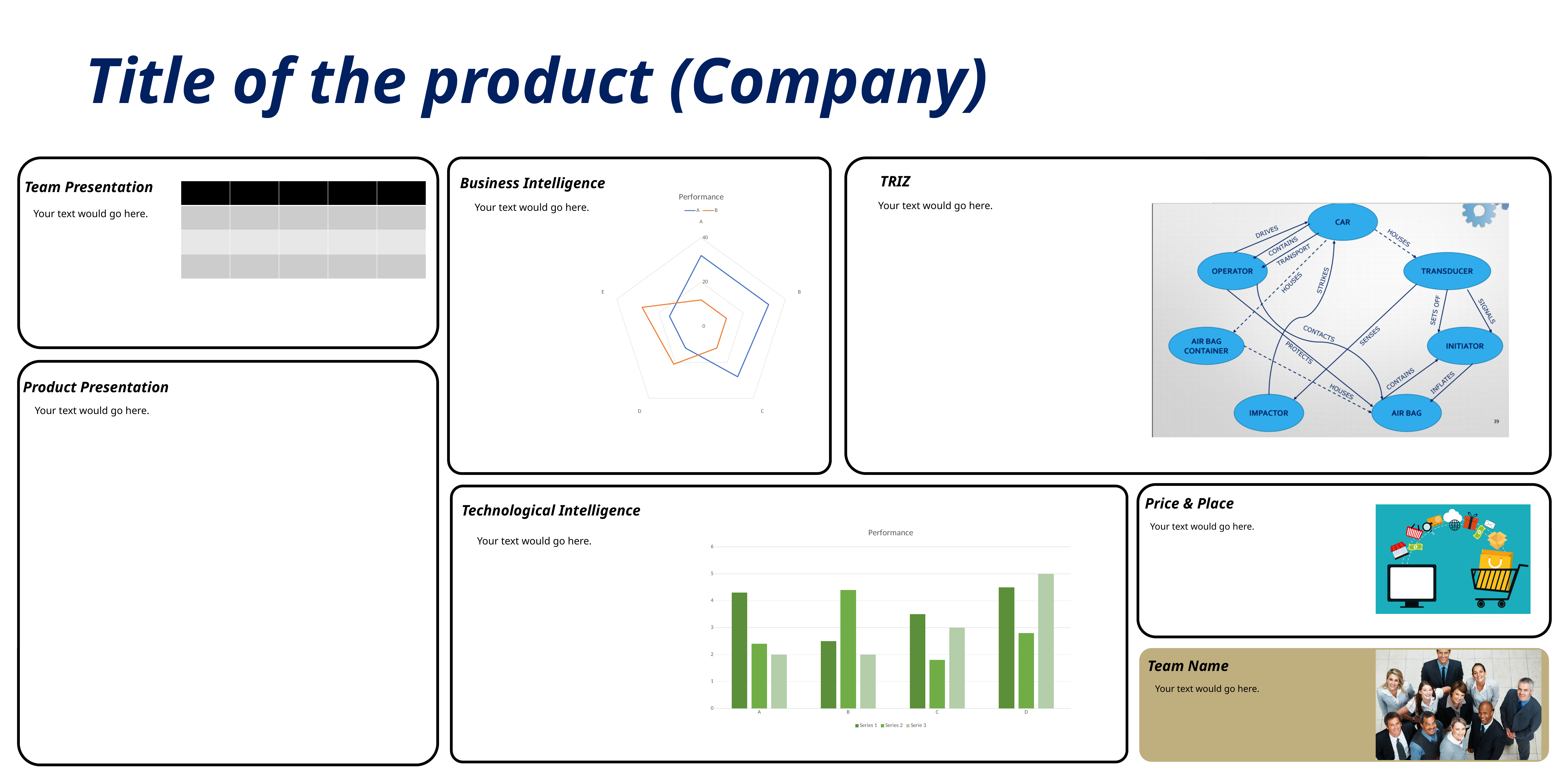
In the Business Intelligence radar chart, how many series does the legend list? 2 What kind of chart is shown in the Business Intelligence section? radar chart In the Technological Intelligence bar chart, what is the value of Serie 3 for category D? 5 In the Technological Intelligence bar chart, how many series does the legend list? 3 In the Technological Intelligence bar chart, how many categories are shown on the x axis? 4 In the Technological Intelligence bar chart, for category B, which is larger: Series 1 or Series 2? Series 2 In the Technological Intelligence bar chart, is the value of Series 1 for category A greater or less than 4? greater In the Business Intelligence radar chart, how many axes (categories) are there? 5 What kind of chart is shown in the Technological Intelligence section? bar chart In the Technological Intelligence bar chart, which category has the highest value for Serie 3? D In the Technological Intelligence bar chart, what is the value of Serie 3 for category C? 3 In the Business Intelligence radar chart, is the value of series A on axis A greater or less than 20? greater